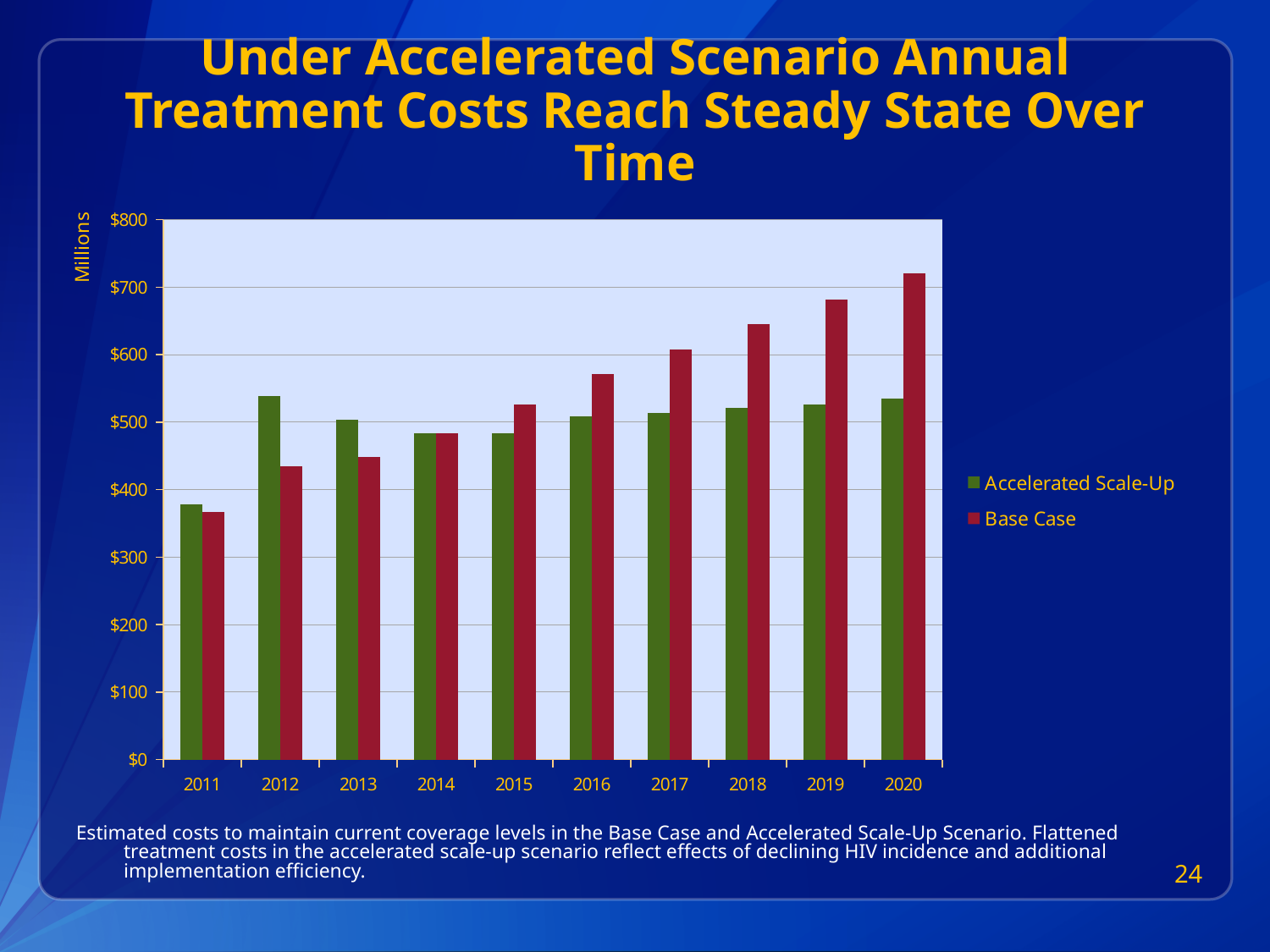
How many series does the legend list? 2 In which year is the Accelerated Scale-Up value lowest? 2011 What kind of chart is shown on the slide? Bar chart How many years are shown along the x axis? 10 In 2020, which series has the larger value, Accelerated Scale-Up or Base Case? Base Case Is the Base Case value for 2011 greater or less than $400? less In which year is the Base Case value lowest? 2011 Do the Base Case values rise or fall from 2011 to 2020? rise In which year is the Accelerated Scale-Up value highest? 2012 Is the Base Case value for 2020 greater or less than $700? greater In 2012, which series has the larger value, Accelerated Scale-Up or Base Case? Accelerated Scale-Up In which year is the Base Case value highest? 2020